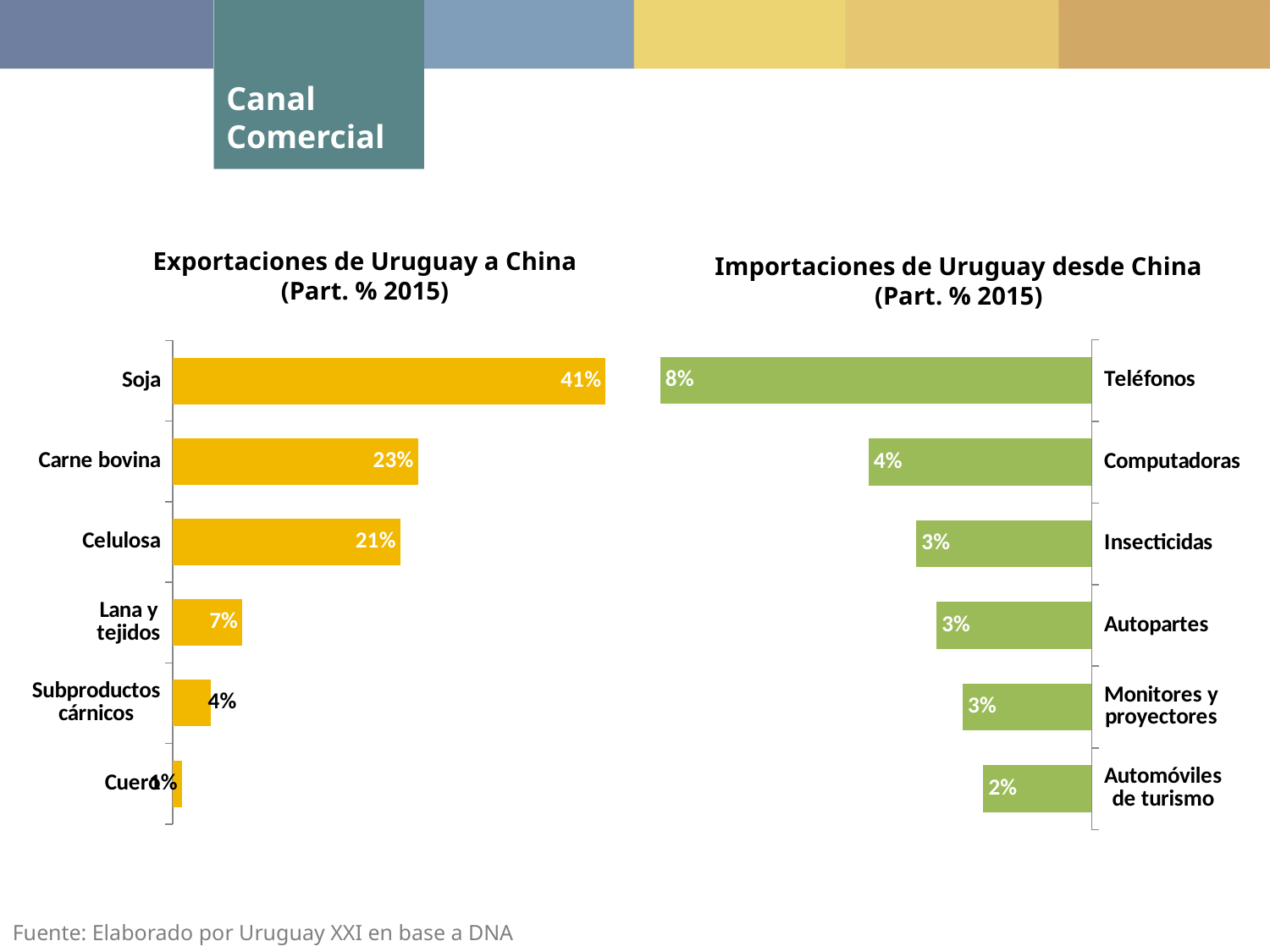
In the 'Importaciones de Uruguay desde China' chart, what is the value for Computadoras? 4% In the 'Exportaciones de Uruguay a China' chart, what is the value for Soja? 41% In the 'Exportaciones de Uruguay a China' chart, which category has the highest value? Soja In the 'Exportaciones de Uruguay a China' chart, what is the difference between Carne bovina and Celulosa? 2% In the 'Exportaciones de Uruguay a China' chart, which is larger, Lana y tejidos or Subproductos cárnicos? Lana y tejidos In the 'Exportaciones de Uruguay a China' chart, what is the value for Celulosa? 21% In the 'Importaciones de Uruguay desde China' chart, which category has the lowest value? Automóviles de turismo In the 'Importaciones de Uruguay desde China' chart, what is the difference between Teléfonos and Computadoras? 4% What kind of chart is the 'Importaciones de Uruguay desde China' chart? Bar chart In the 'Importaciones de Uruguay desde China' chart, what is the value for Teléfonos? 8% What colour are the bars in the 'Exportaciones de Uruguay a China' chart? Yellow In the 'Exportaciones de Uruguay a China' chart, how many categories are shown? 6